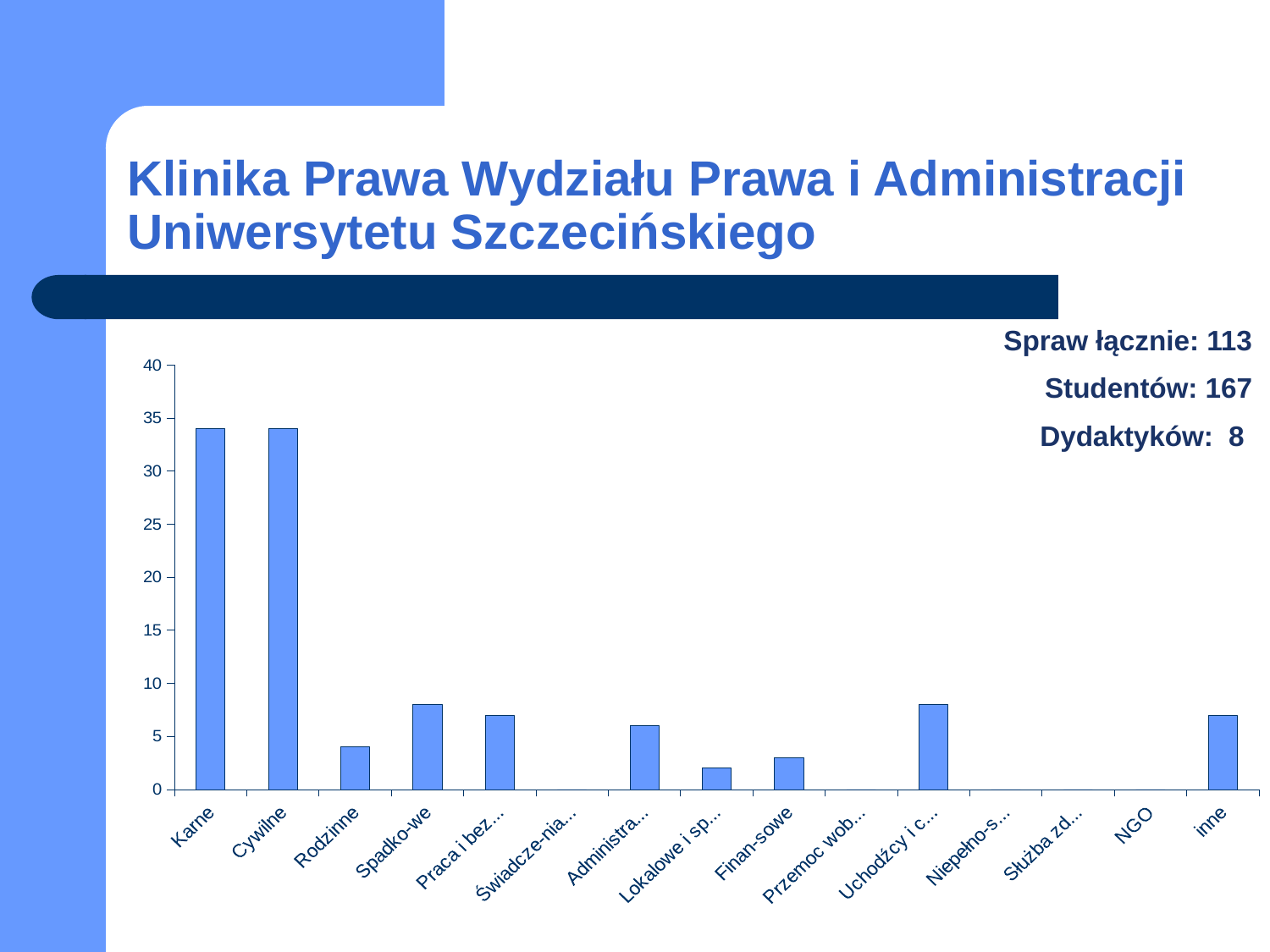
What is the highest value shown on the y axis of the chart? 40 Which is larger, the value for Uchodźcy i c... or the value for Finan-sowe? Uchodźcy i c... What kind of chart is shown on the slide? bar chart Is the value for Spadko-we greater or less than 5? greater Is the value for Uchodźcy i c... greater or less than 5? greater How many categories are shown on the x axis of the chart? 15 Is the value for Rodzinne greater or less than 5? less Which is larger, the value for Karne or the value for Rodzinne? Karne Which is larger, the value for Spadko-we or the value for Lokalowe i sp...? Spadko-we